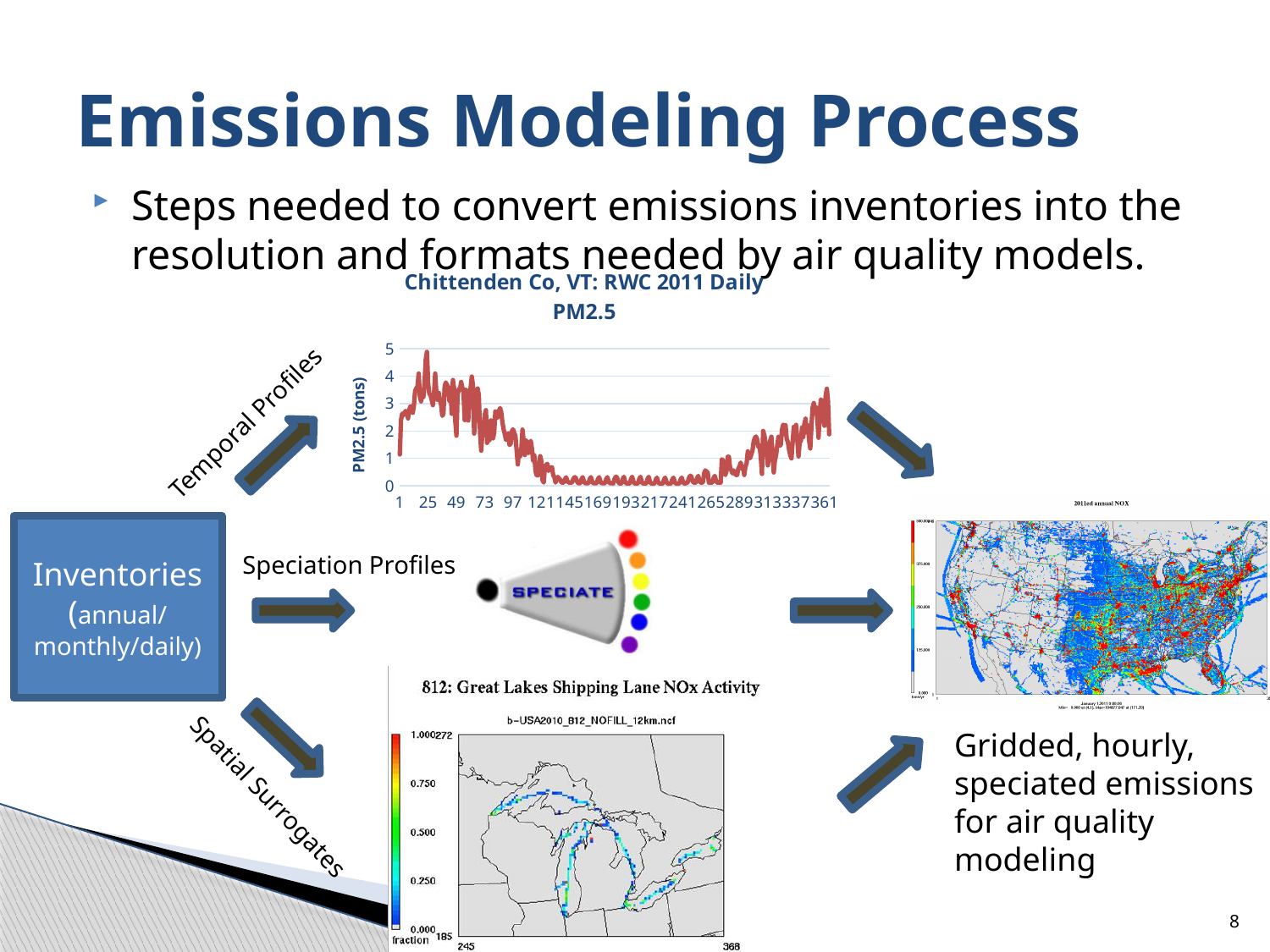
In the 'Chittenden Co, VT: RWC 2011 Daily PM2.5' chart, in which part of the year do the lowest values occur: the beginning, the middle, or the end? the middle In the 'Chittenden Co, VT: RWC 2011 Daily PM2.5' chart, do the values rise or fall between day 241 and day 361? rise What kind of chart is the 'Chittenden Co, VT: RWC 2011 Daily PM2.5' chart? line chart What is the title of the line chart on the slide? Chittenden Co, VT: RWC 2011 Daily PM2.5 What is the y-axis label of the 'Chittenden Co, VT: RWC 2011 Daily PM2.5' chart? PM2.5 (tons) What is the highest tick value shown on the y-axis of the 'Chittenden Co, VT: RWC 2011 Daily PM2.5' chart? 5 In the 'Chittenden Co, VT: RWC 2011 Daily PM2.5' chart, in which part of the year do the highest values occur: the beginning, the middle, or the end? the beginning In the 'Chittenden Co, VT: RWC 2011 Daily PM2.5' chart, is the value around day 193 greater or less than 1? less In the 'Chittenden Co, VT: RWC 2011 Daily PM2.5' chart, is the peak value near day 25 greater or less than 4? greater In the 'Chittenden Co, VT: RWC 2011 Daily PM2.5' chart, do the values rise or fall between day 1 and day 193? fall In the 'Chittenden Co, VT: RWC 2011 Daily PM2.5' chart, which is larger: the value around day 25 or the value around day 193? day 25